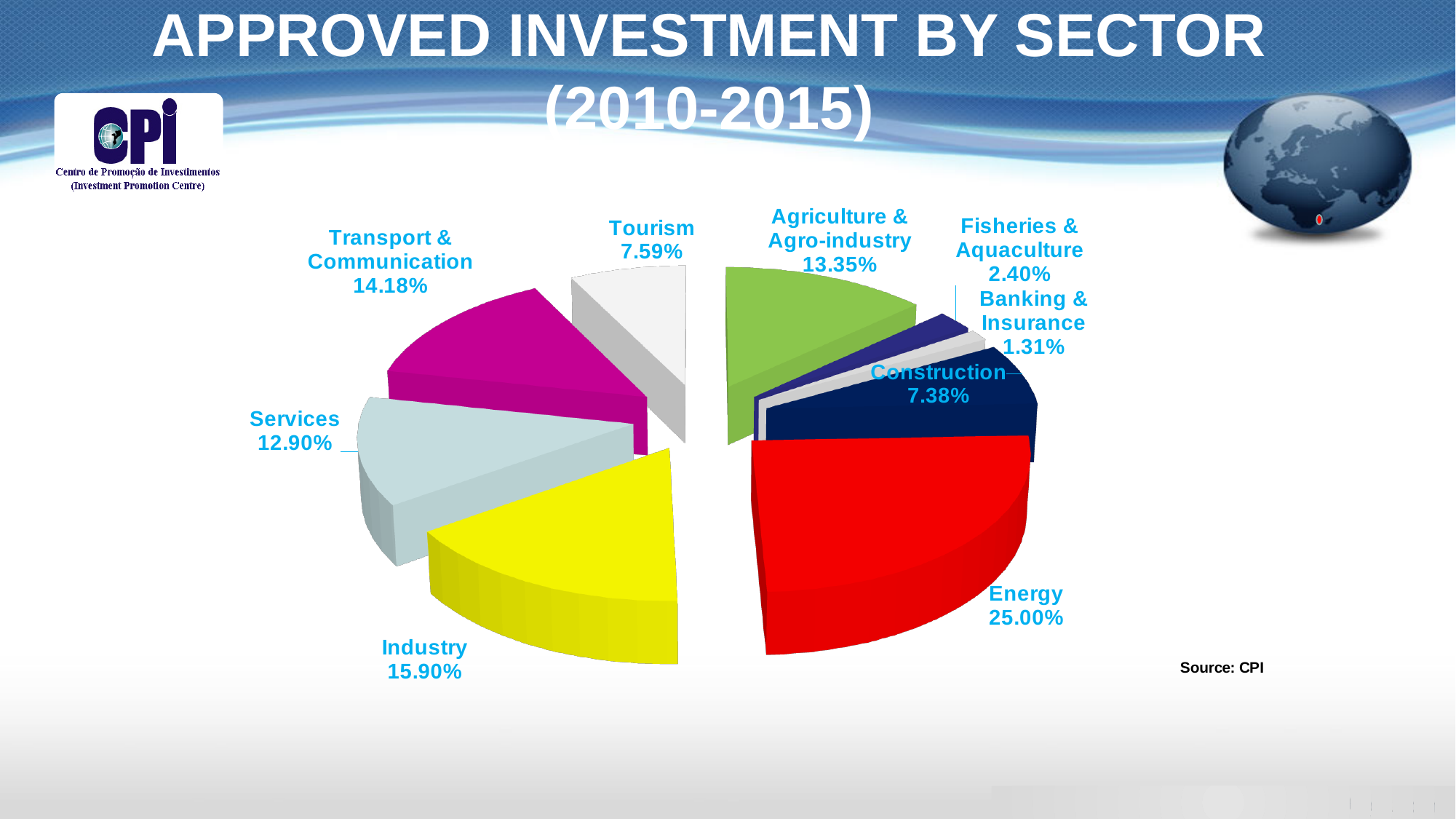
How many sectors are shown in the pie chart? 9 What percentage is shown for Fisheries & Aquaculture? 2.40% What colour is the Industry slice? Yellow Which sector has the largest share of approved investment? Energy What is the title of the chart? APPROVED INVESTMENT BY SECTOR (2010-2015) What is the value labelled for Banking & Insurance? 1.31% What share of approved investment does the Energy sector account for? 25.00% What kind of chart is shown on the slide? Pie chart Which sector has the smallest share of approved investment? Banking & Insurance What is the difference in percentage points between Industry and Services? 3.00 What percentage is shown for Transport & Communication? 14.18% Which has a larger share, Tourism or Construction? Tourism